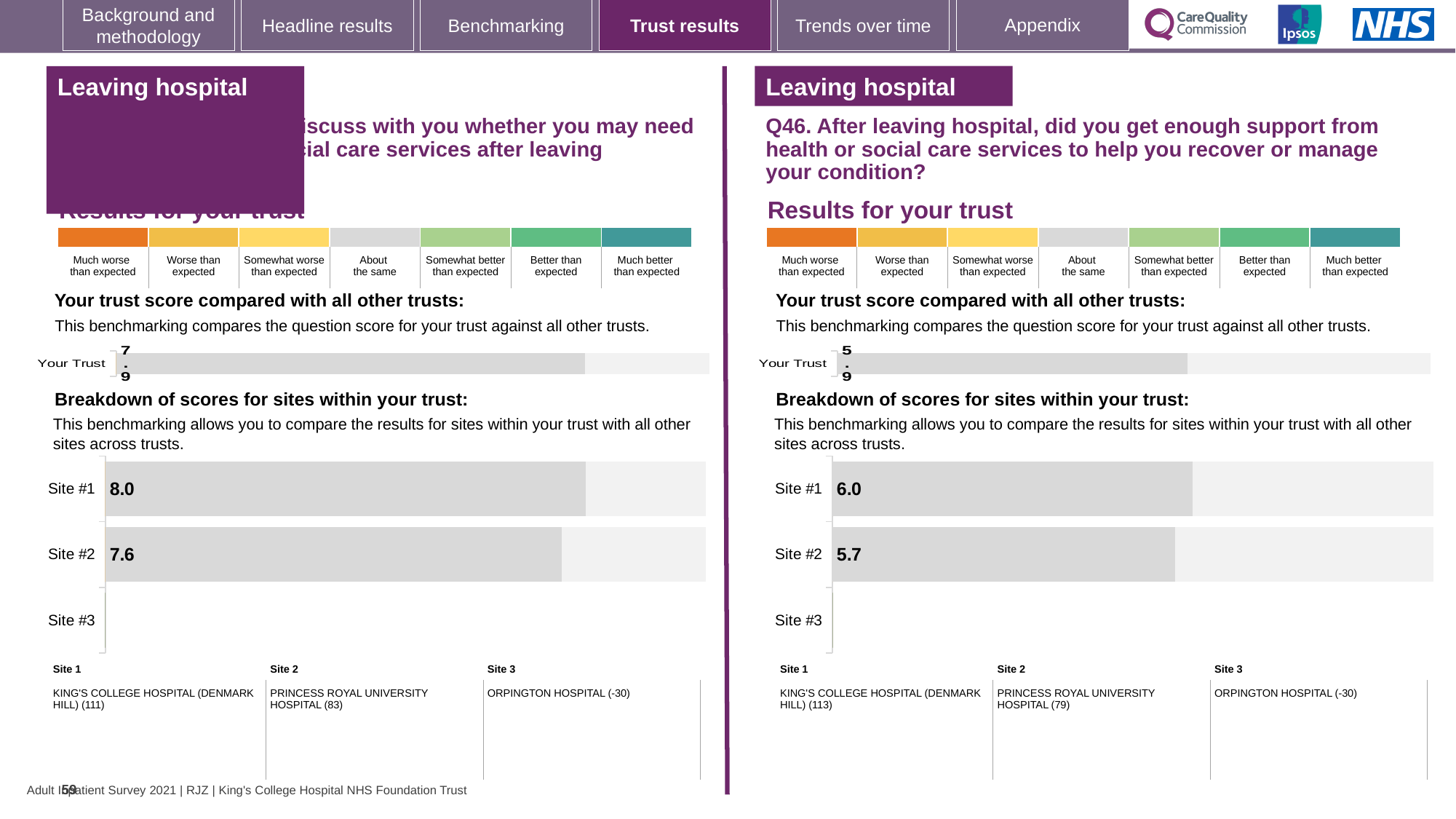
On the left-hand 'Your trust score compared with all other trusts' chart, what is the score for Your Trust? 7.9 On the left-hand 'Breakdown of scores for sites within your trust' chart, which site has the higher score, Site #1 or Site #2? Site #1 On the right-hand (Q46) 'Your trust score compared with all other trusts' chart, what is the score for Your Trust? 5.9 On the right-hand (Q46) 'Breakdown of scores for sites within your trust' chart, what is the difference between the scores for Site #1 and Site #2? 0.3 On the left-hand 'Breakdown of scores for sites within your trust' chart, what is the score for Site #1? 8.0 What kind of chart is the right-hand (Q46) 'Breakdown of scores for sites within your trust' chart? Bar chart On the left-hand 'Breakdown of scores for sites within your trust' chart, what is the difference between the scores for Site #1 and Site #2? 0.4 On the left-hand 'Breakdown of scores for sites within your trust' chart, what is the score for Site #2? 7.6 On the right-hand (Q46) 'Breakdown of scores for sites within your trust' chart, what is the score for Site #1? 6.0 How many site categories are listed on the right-hand (Q46) 'Breakdown of scores for sites within your trust' chart? 3 On the right-hand (Q46) 'Breakdown of scores for sites within your trust' chart, which site has no bar plotted? Site #3 On the right-hand (Q46) 'Breakdown of scores for sites within your trust' chart, what is the score for Site #2? 5.7